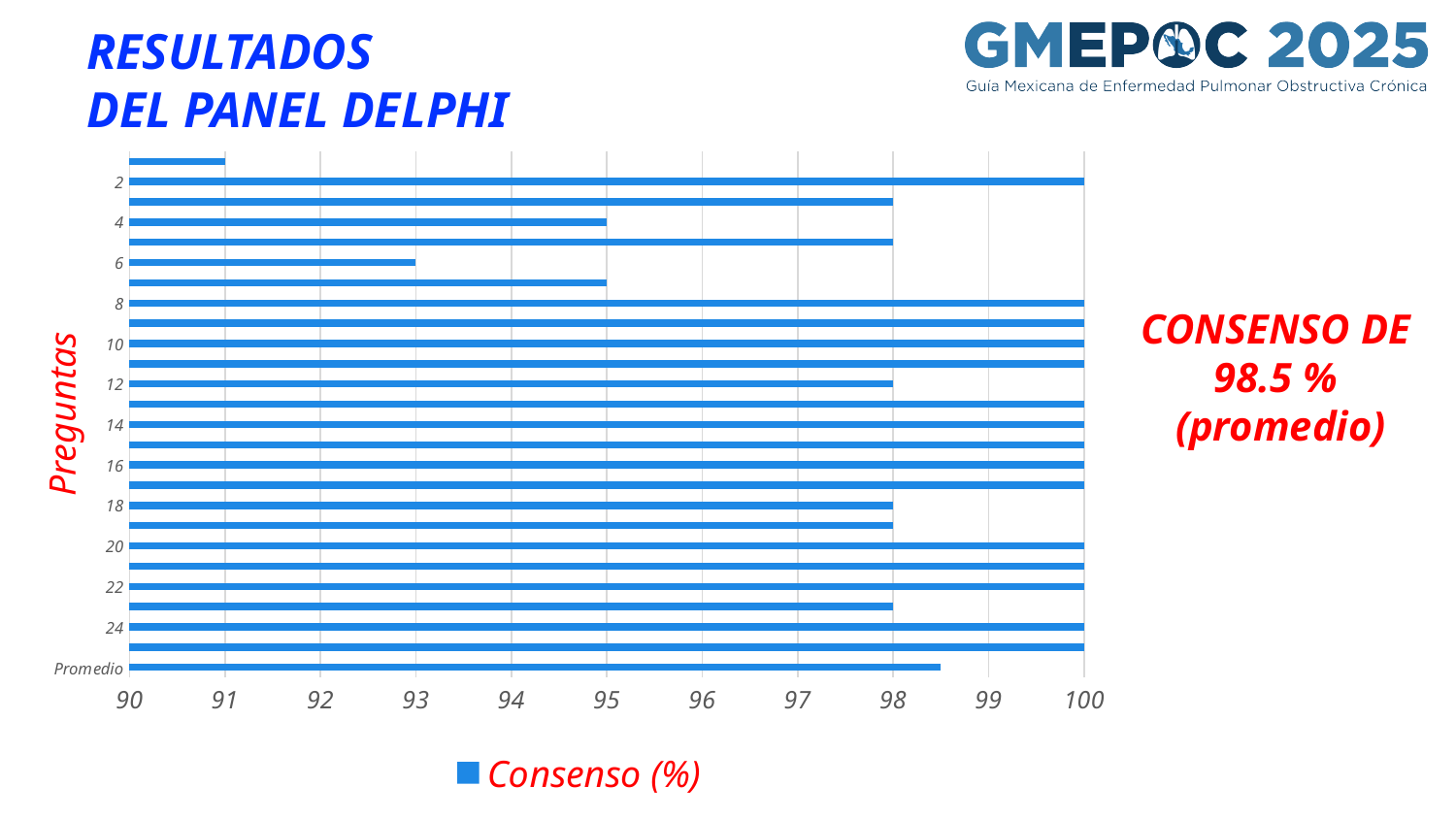
What kind of chart is shown on the slide? bar chart What is the consensus value for question 12? 98 Which has a higher consensus value, question 4 or question 6? question 4 Is the value for question 6 greater or less than 95? less What is the consensus value for question 4? 95 What is the value of the Promedio bar? 98.5 % What is the consensus value for question 18? 98 What is the consensus value for question 2? 100 How many series does the legend list? 1 What is the difference between the consensus values for question 12 and question 6? 5 What is the consensus value for question 6? 93 What is the legend entry for the series? Consenso (%)